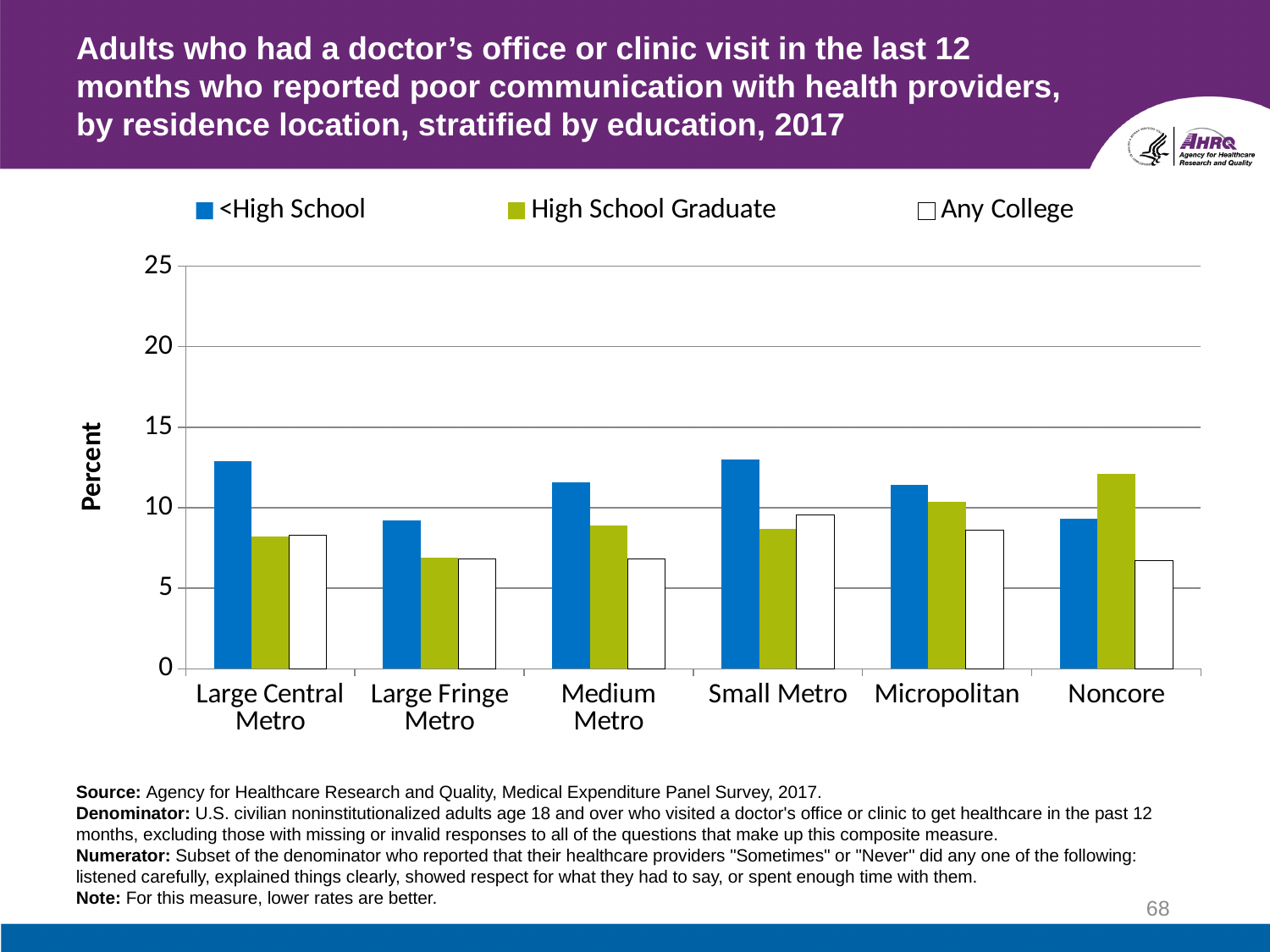
In Noncore, which is larger: the <High School value or the High School Graduate value? High School Graduate Is the value for High School Graduate in Noncore greater or less than 10? greater Which residence location has the highest value for High School Graduate? Noncore What kind of chart is shown on the slide? Bar chart How many series does the legend list? 3 Is the value for Any College in Large Fringe Metro greater or less than 10? less Which residence location has the highest value for Any College? Small Metro How many residence location categories are shown on the x axis? 6 Is the value for <High School in Large Central Metro greater or less than 10? greater In Medium Metro, which is larger: the High School Graduate value or the Any College value? High School Graduate What is the label on the y axis? Percent